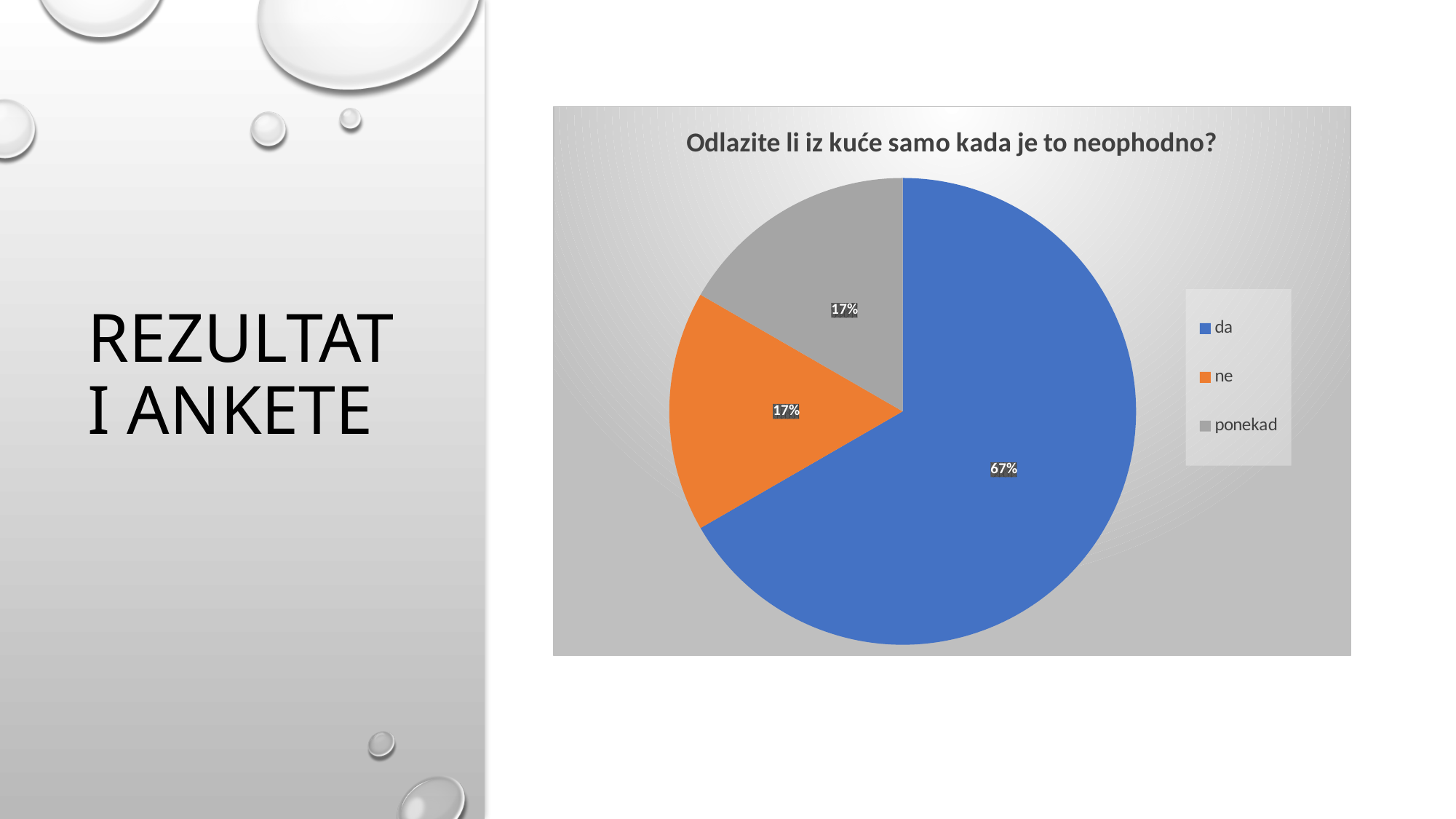
Is the share for "da" greater or less than 50%? greater Which category has the largest slice of the pie? da What kind of chart is shown on the slide? pie chart What share of the pie does the "ponekad" slice represent? 17% What is the difference between the "da" share and the "ponekad" share? 50% How many slices does the pie chart have? 3 Which colour represents the "ne" category in the chart? orange Which is larger, the "da" slice or the "ne" slice? da How many categories does the legend list? 3 What share of the pie does the "da" slice represent? 67% What share of the pie does the "ne" slice represent? 17% What is the title of the chart? Odlazite li iz kuće samo kada je to neophodno?